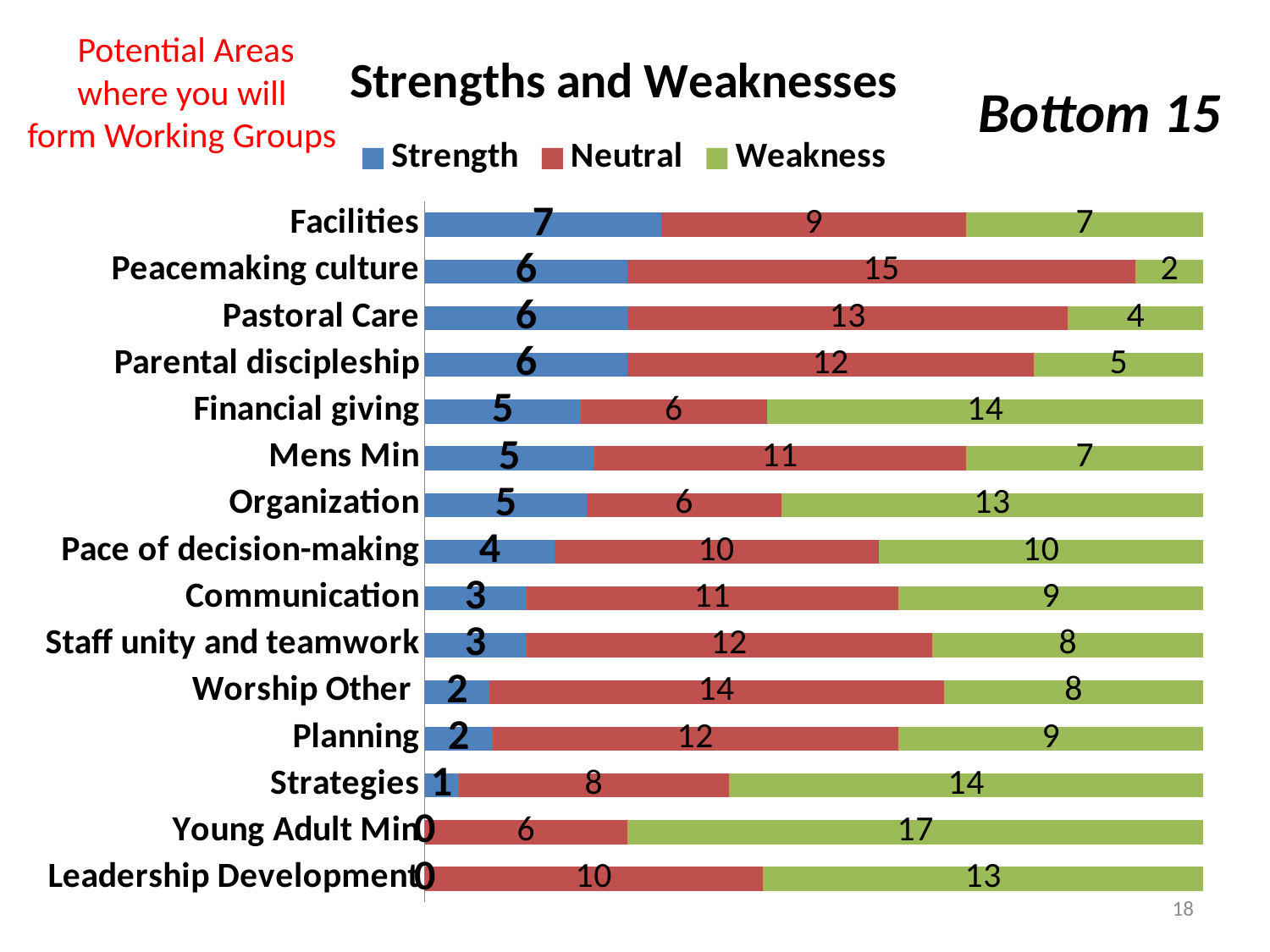
Which is larger, the Neutral value for Worship Other or the Neutral value for Planning? Worship Other What is the Strength value for Facilities? 7 What kind of chart is shown on the slide? Stacked bar chart What is the Weakness value for Young Adult Min? 17 What is the difference between the Weakness value for Financial giving and the Weakness value for Mens Min? 7 How many categories are shown on the chart? 15 Which category has the highest Weakness value? Young Adult Min Which category has the lowest Weakness value? Peacemaking culture Which category has the highest Strength value? Facilities How many series does the legend list? 3 What is the Neutral value for Peacemaking culture? 15 What is the total of the stacked bar for Strategies? 23